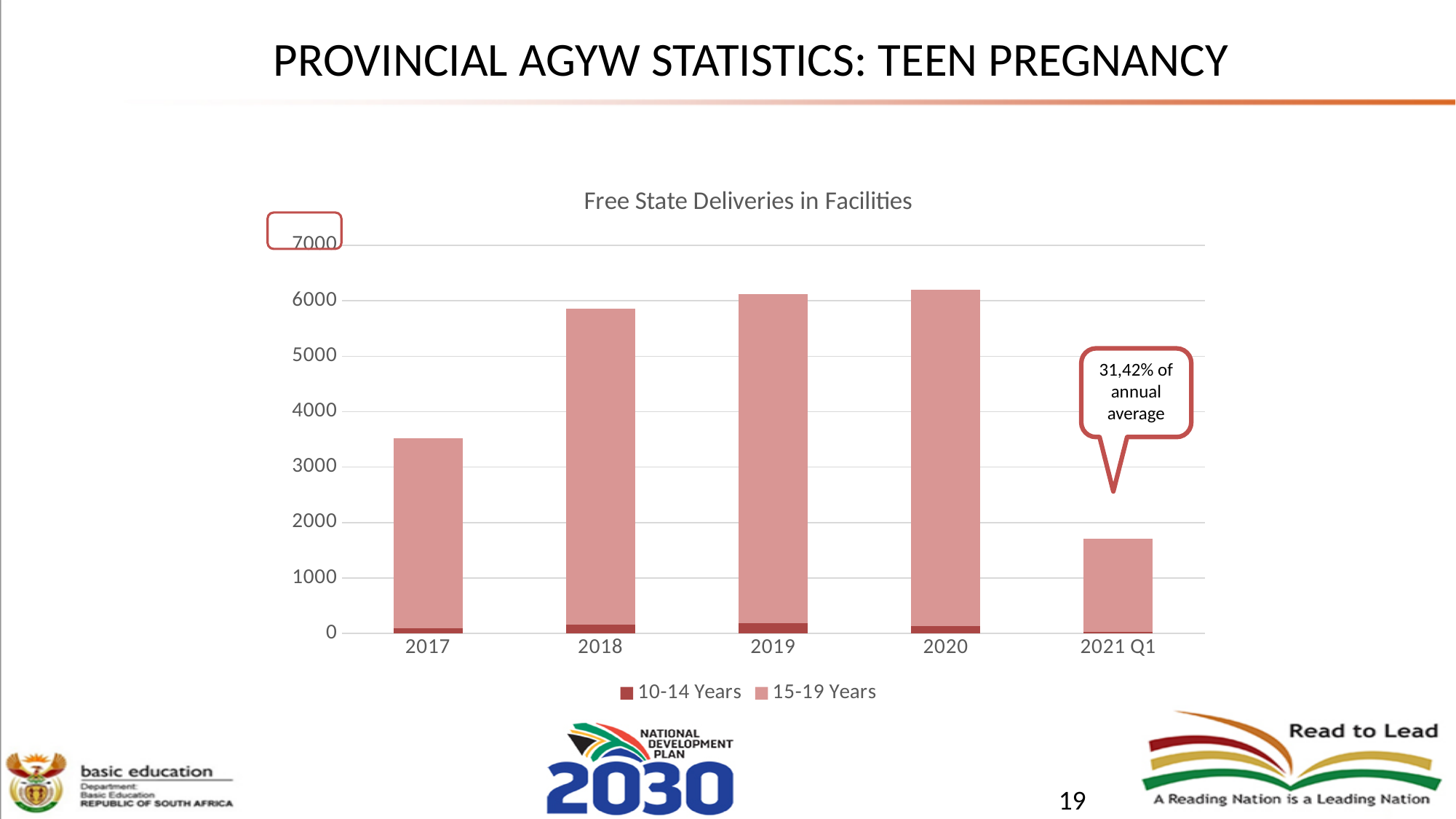
Which has the larger total bar, 2017 or 2018? 2018 Do the total bars rise or fall from 2017 to 2020? rise Is the total value for 2017 greater or less than 4000? less Is the total value for 2018 greater or less than 5000? greater What is the title of the chart? Free State Deliveries in Facilities What kind of chart is shown on the slide? Bar chart Is the total value for 2020 greater or less than 7000? less What does the callout next to the 2021 Q1 bar say? 31,42% of annual average Which category has the lowest total bar? 2021 Q1 How many series does the legend list? 2 How many categories are shown on the x axis? 5